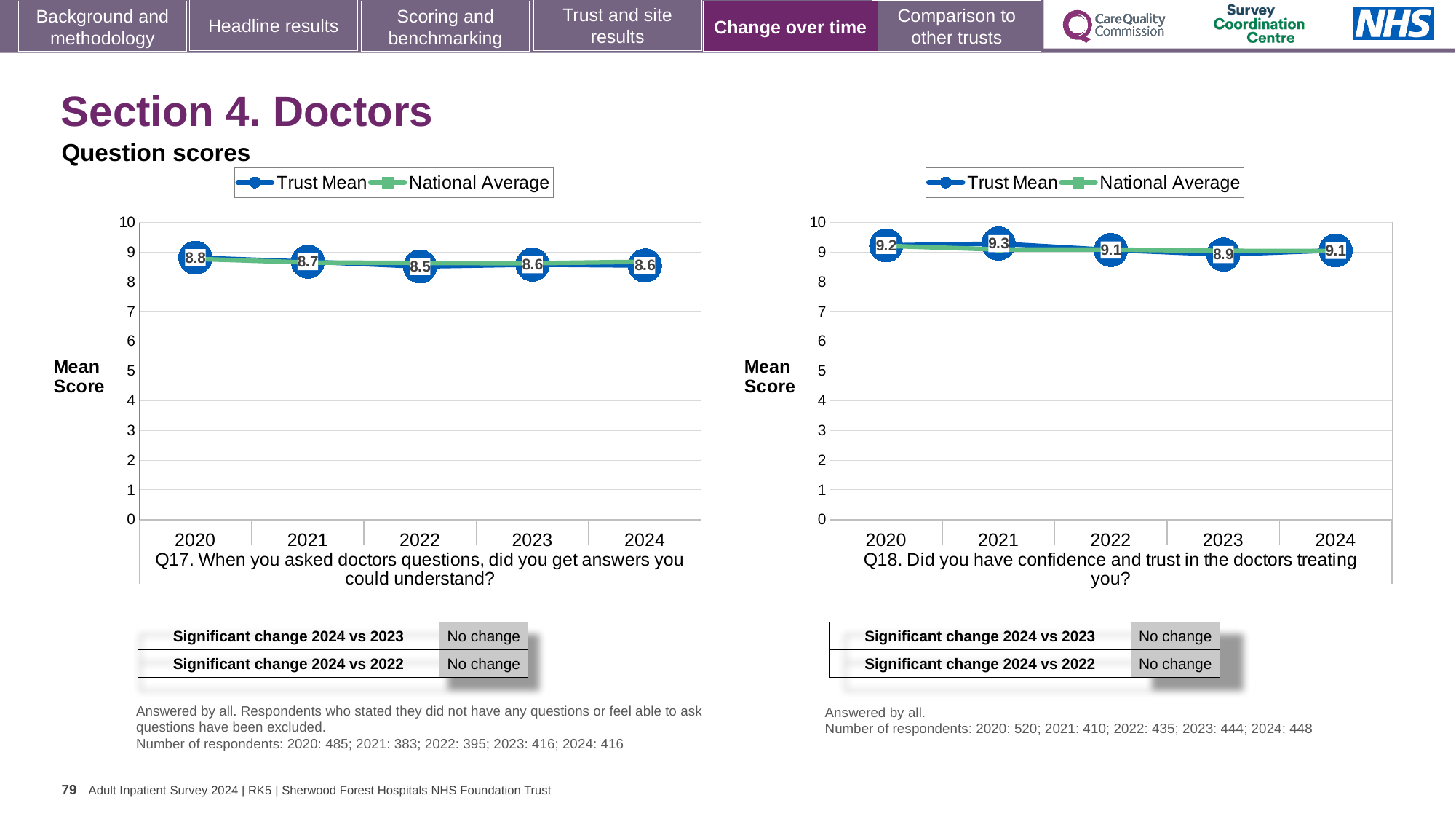
On the Q18 chart, what is the Trust Mean score for 2023? 8.9 On the Q18 chart, which year has the lowest Trust Mean score? 2023 On the Q18 chart, what is the difference between the Trust Mean scores for 2021 and 2023? 0.4 How many years are plotted on the Q18 chart? 5 What kind of chart is the Q18 chart? line chart How many series does the legend of the Q17 chart list? 2 On the Q17 chart, is the Trust Mean value for 2024 greater or less than 9? less On the Q17 chart, which year has the highest Trust Mean score? 2020 On the Q17 chart, what is the Trust Mean score for 2022? 8.5 On the Q17 chart, what is the Trust Mean score for 2020? 8.8 On the Q18 chart, what is the Trust Mean score for 2021? 9.3 On the Q17 chart, is the Trust Mean score for 2020 or 2022 larger? 2020